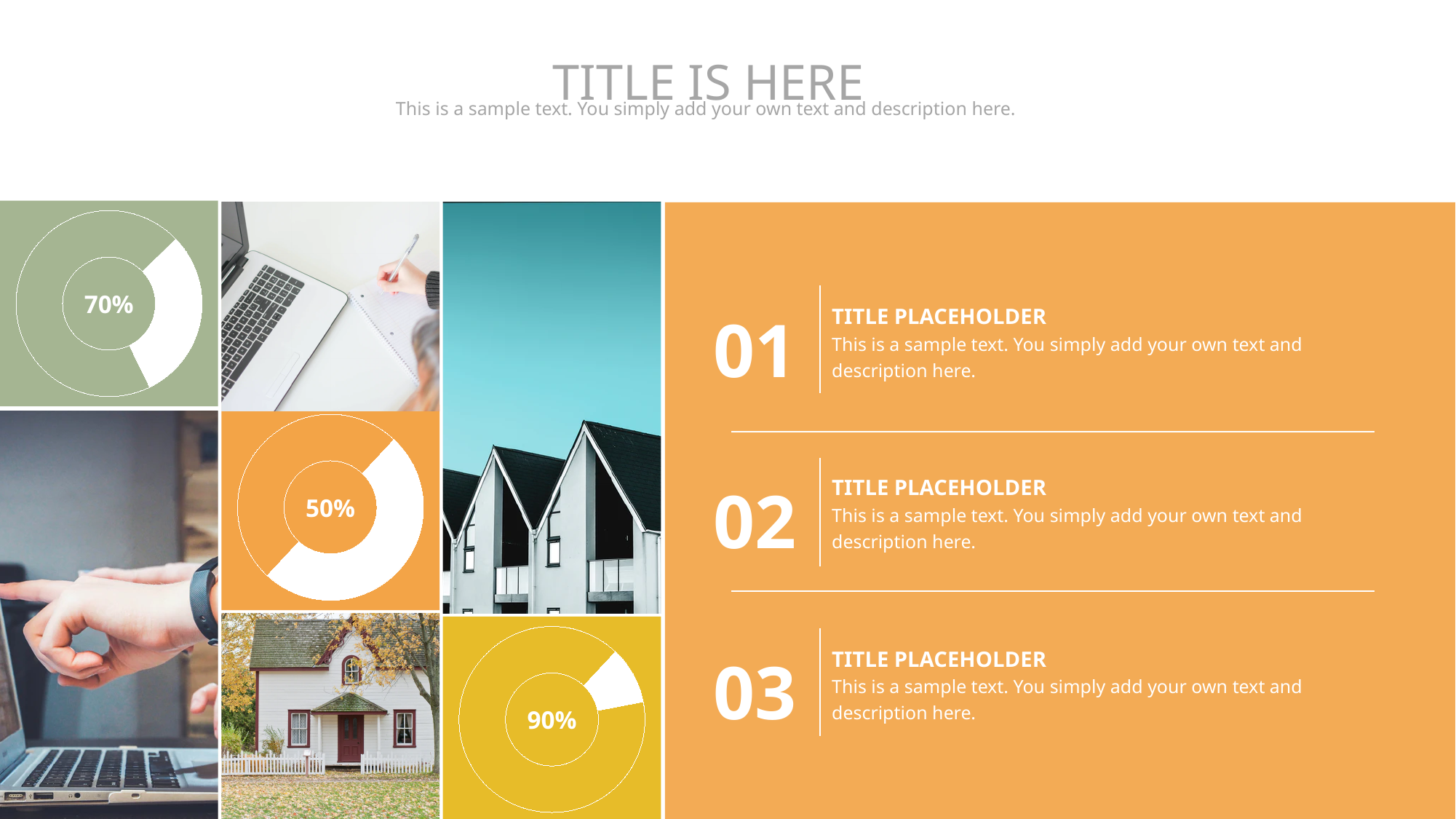
How many donut charts are shown on the slide? 3 What is the difference between the percentage in the yellow donut chart and the percentage in the green donut chart? 20% What percentage is shown in the orange donut chart in the middle of the image grid? 50% What percentage is shown in the green donut chart at the top left of the image grid? 70% Which of the three donut charts shows the highest percentage? The yellow chart (90%) What is the difference between the percentage in the green donut chart and the percentage in the orange donut chart? 20% Which shows a larger value, the green donut chart or the orange donut chart? The green donut chart Which of the three donut charts shows the lowest percentage? The orange chart (50%) What kind of chart is used to display the percentages on the slide? Donut chart Is the value in the yellow donut chart greater or less than 80%? greater What percentage is shown in the yellow donut chart at the bottom right of the image grid? 90% What colour is the donut chart that shows 50%? Orange